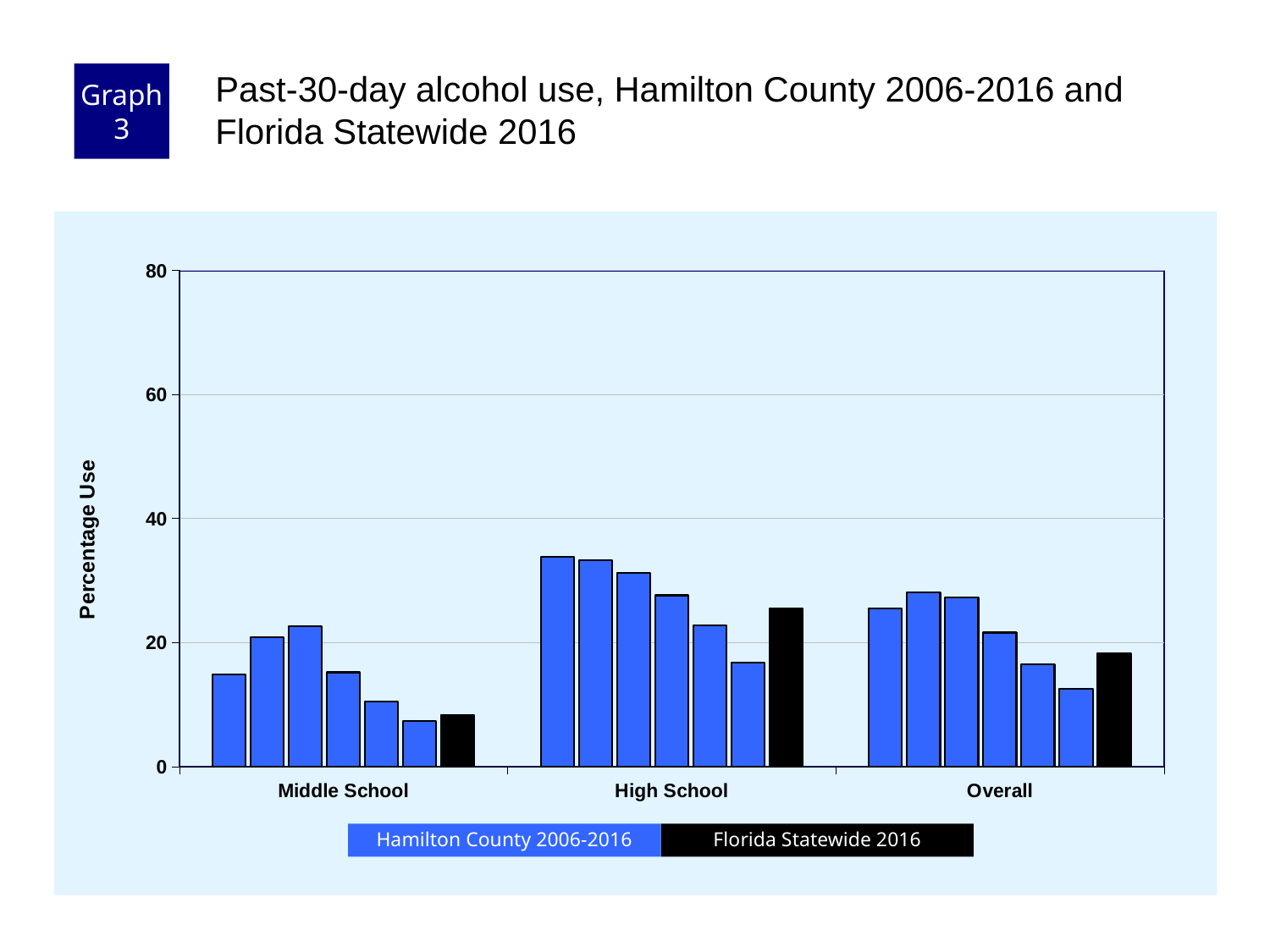
Is the Florida Statewide 2016 value for Overall greater or less than 20? less Which category has the highest Florida Statewide 2016 value? High School Which colour represents Florida Statewide 2016 in the chart? black Which category has the lowest Florida Statewide 2016 value? Middle School Is the Florida Statewide 2016 value for Middle School greater or less than 20? less What is the label on the y axis? Percentage Use How many series does the legend list? 2 What kind of chart is shown on the slide? bar chart Is the Florida Statewide 2016 value for High School greater or less than 20? greater Do the Hamilton County 2006-2016 bars for High School rise or fall from left to right? fall How many categories are shown on the x axis? 3